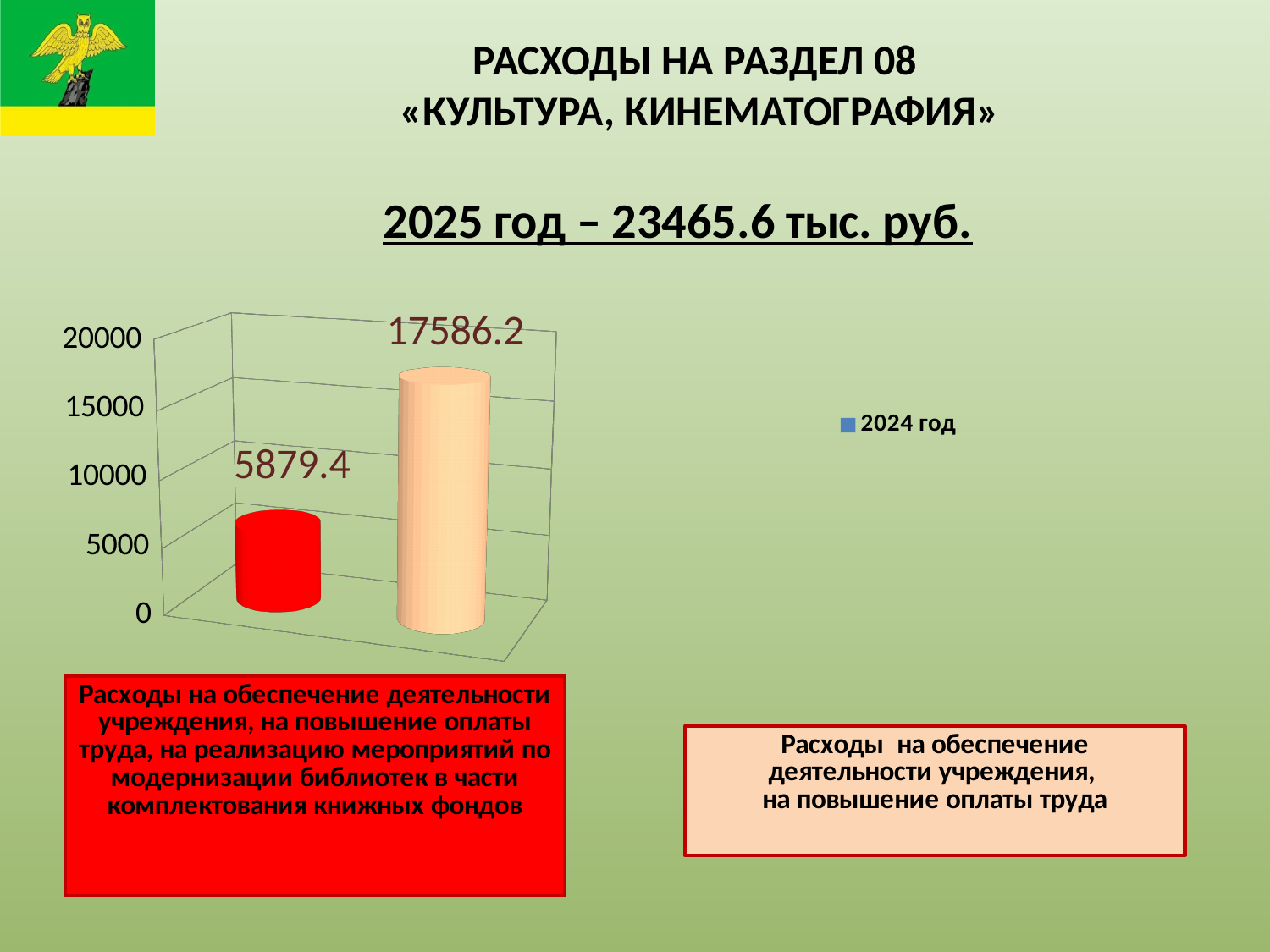
What is the difference between the values of the peach-coloured bar and the red bar? 11706.8 How many series does the chart legend list? 1 Which bar has the lowest value, the red one or the peach-coloured one? the red bar Is the value of the red bar greater or less than 10000? less What value is shown on the red bar in the chart? 5879.4 What kind of chart is shown on the slide? bar chart Is the value of the peach-coloured bar greater or less than 15000? greater Is the value of the red bar larger or smaller than the value of the peach-coloured bar? smaller What is the legend entry shown next to the chart? 2024 год How many bars are plotted in the chart? 2 Which bar has the highest value, the red one or the peach-coloured one? the peach-coloured bar What value is shown on the peach-coloured bar in the chart? 17586.2